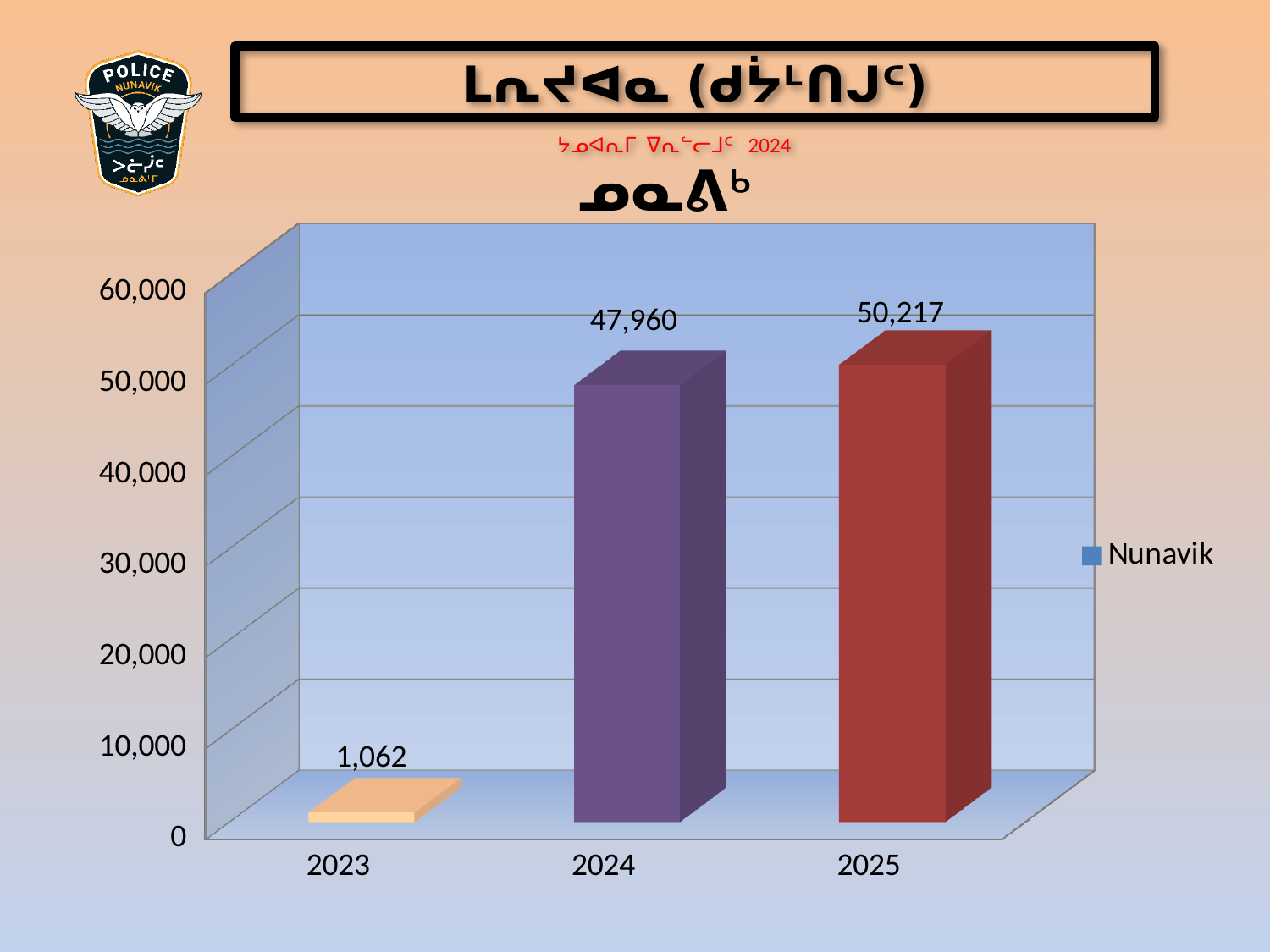
Which year has the highest value? 2025 What series name does the legend show? Nunavik What is the value for 2023? 1,062 What kind of chart is shown? bar chart Which year has the lowest value? 2023 What is the value for 2025? 50,217 What is the difference between the values for 2024 and 2023? 46,898 What is the value for 2024? 47,960 How many years are shown on the x axis? 3 Which is larger, the value for 2024 or the value for 2025? 2025 Is the value for 2025 greater or less than 40,000? greater What is the difference between the values for 2025 and 2024? 2,257